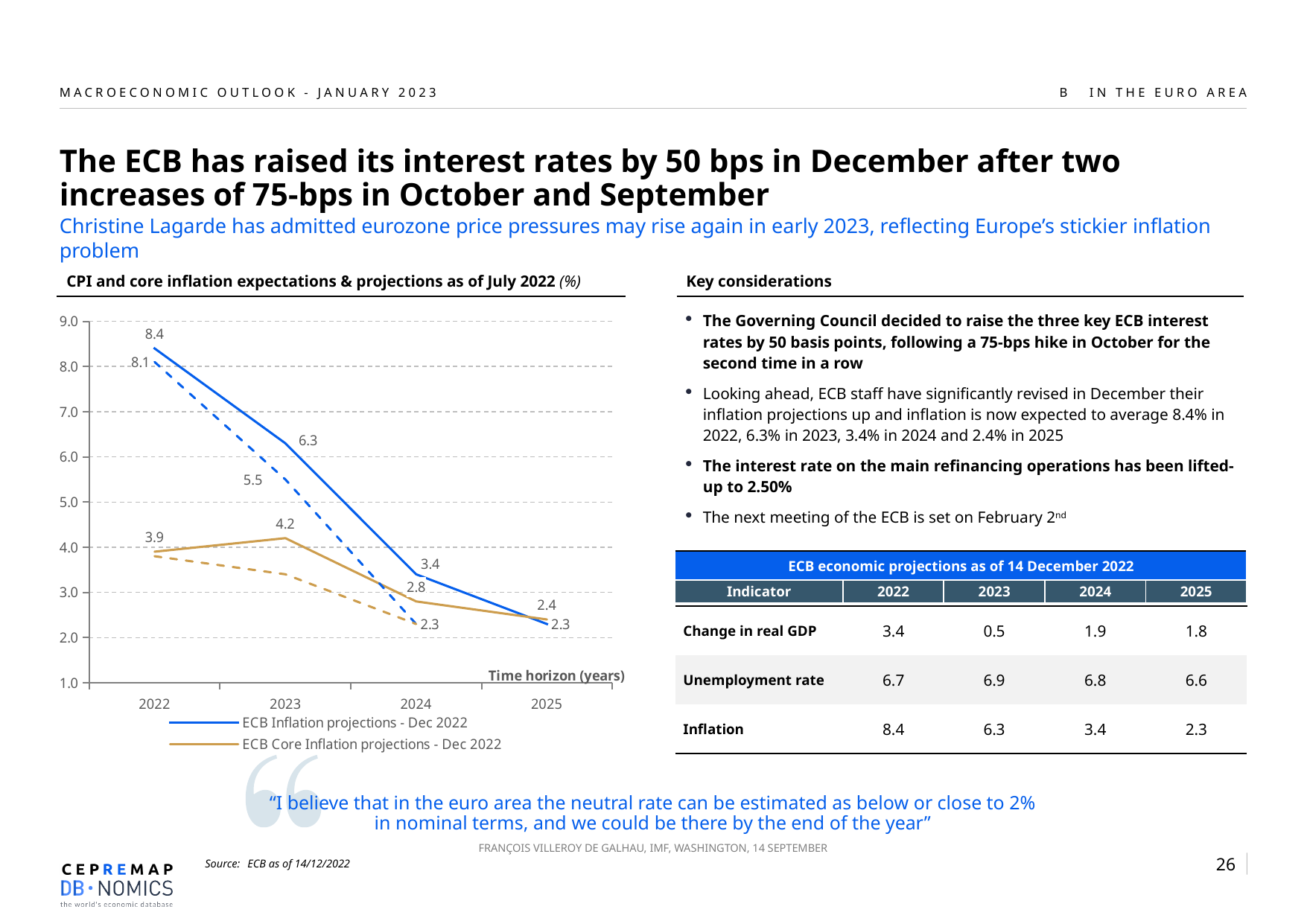
What is the ECB Inflation projection (Dec 2022) for 2022? 8.4 What is the ECB Inflation projection (Dec 2022) for 2024? 3.4 What is the ECB Inflation projection (Dec 2022) for 2023? 6.3 What is the difference between the ECB Inflation projection (Dec 2022) for 2022 and for 2023? 2.1 Does the ECB Inflation projection (Dec 2022) rise or fall from 2022 to 2025? fall How many series does the chart legend list? 2 What is the ECB Core Inflation projection (Dec 2022) for 2024? 2.8 Which is larger in 2024: the ECB Inflation projection or the ECB Core Inflation projection (Dec 2022)? ECB Inflation projection In which year is the ECB Inflation projection (Dec 2022) highest? 2022 What type of chart is shown on the slide? line chart What is the ECB Inflation projection (Dec 2022) for 2025? 2.3 What is the ECB Core Inflation projection (Dec 2022) for 2023? 4.2